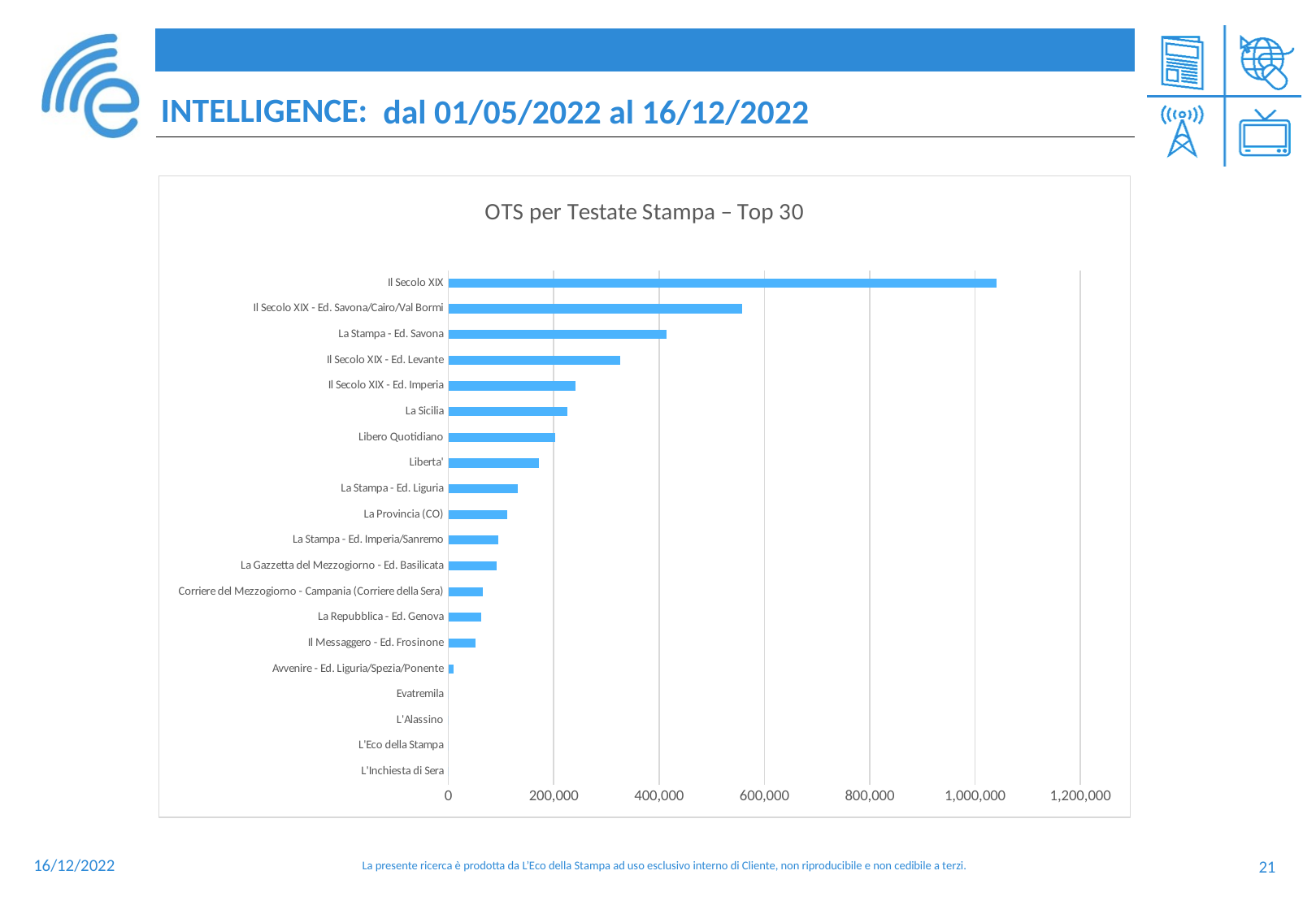
Which has a larger value, Liberta' or La Stampa - Ed. Liguria? Liberta' How many categories (testate) are listed on the chart's vertical axis? 20 What type of chart is shown on the slide? bar chart Is the value for Il Secolo XIX greater or less than 1,000,000? greater Do the bar values rise or fall going from the top category to the bottom category? fall Is the value for Il Secolo XIX - Ed. Levante greater or less than 400,000? less Is the value for Il Secolo XIX - Ed. Savona/Cairo/Val Bormi greater or less than 600,000? less Which testata has the highest OTS value? Il Secolo XIX What is the title of the chart? OTS per Testate Stampa – Top 30 Which has a larger value, Il Secolo XIX - Ed. Levante or Il Secolo XIX - Ed. Imperia? Il Secolo XIX - Ed. Levante